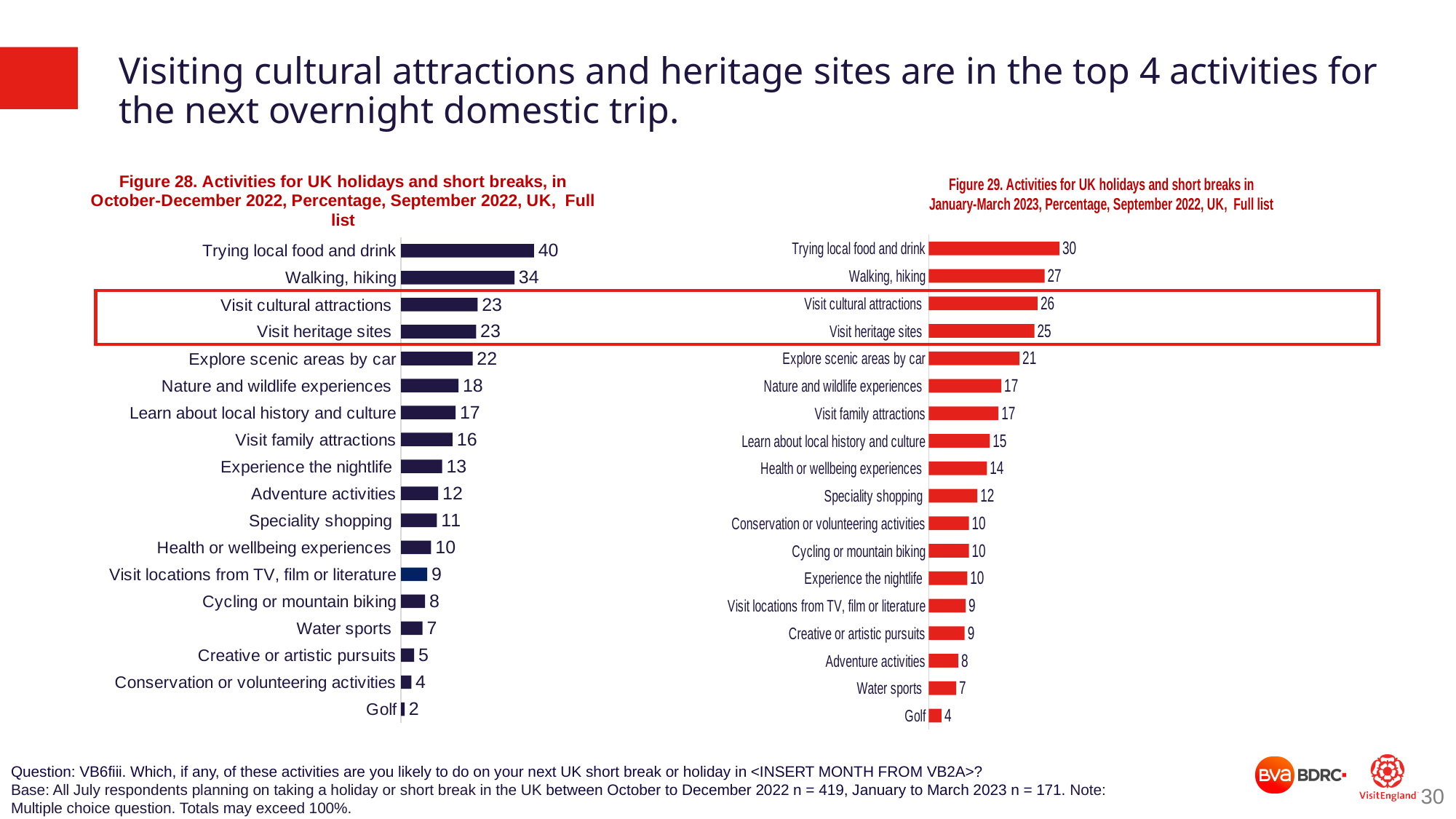
How many activities are listed in Figure 28 (left chart)? 18 In Figure 29 (right chart), which is larger: Speciality shopping or Health or wellbeing experiences? Health or wellbeing experiences In Figure 29 (right chart), what is the value for Visit cultural attractions? 26 In Figure 29 (right chart), what is the difference between Visit heritage sites and Golf? 21 In Figure 28 (left chart), which activity has the lowest value? Golf In Figure 28 (left chart), what is the value for Water sports? 7 In Figure 28 (left chart), what is the difference between Trying local food and drink and Walking, hiking? 6 In Figure 29 (right chart), which activity has the highest value? Trying local food and drink In Figure 28 (left chart), what is the value for Trying local food and drink? 40 In Figure 28 (left chart), which is larger: Experience the nightlife or Adventure activities? Experience the nightlife What type of chart is Figure 29 (right chart)? Bar chart How many activities are listed in Figure 29 (right chart)? 18